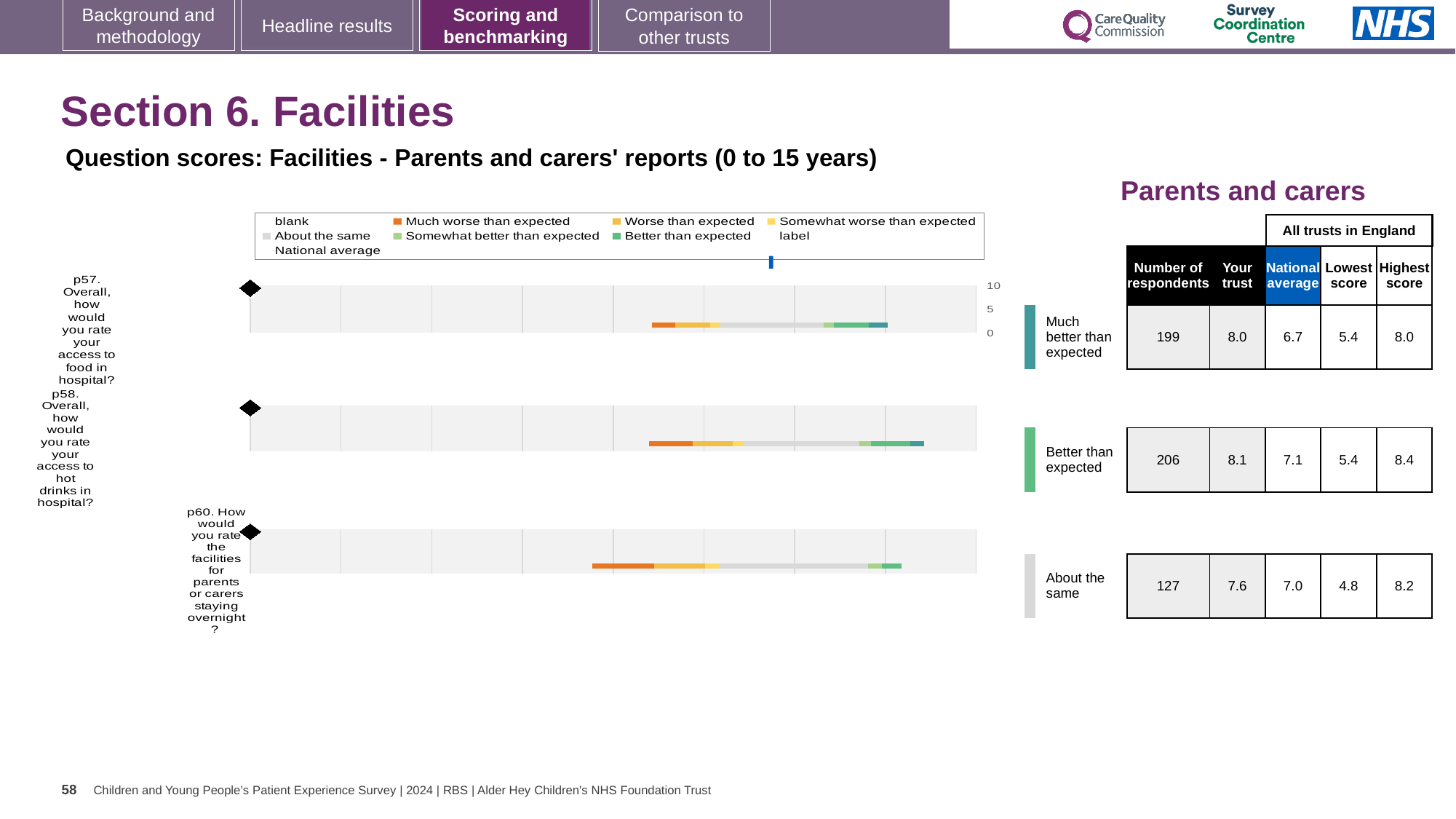
Is the 'Your trust' score for p60 greater or less than 5? greater What is the difference between the 'Your trust' score and the national average for p58? 1.0 What is the 'Your trust' score for p57 (access to food in hospital)? 8.0 How many questions (categories) are plotted in the Facilities question scores chart? 3 What is the national average score for p60 (facilities for parents or carers staying overnight)? 7.0 Which question has the lowest 'Your trust' score? p60. How would you rate the facilities for parents or carers staying overnight? How many respondents answered p57 (access to food in hospital)? 199 What kind of chart is used to show the question scores for Facilities? bar chart What is the 'Your trust' score for p58 (access to hot drinks in hospital)? 8.1 For p57, which is larger: the 'Your trust' score or the national average? Your trust Which benchmarking category is p57 (access to food in hospital) placed in? Much better than expected Which question has the highest 'Your trust' score? p58. Overall, how would you rate your access to hot drinks in hospital?